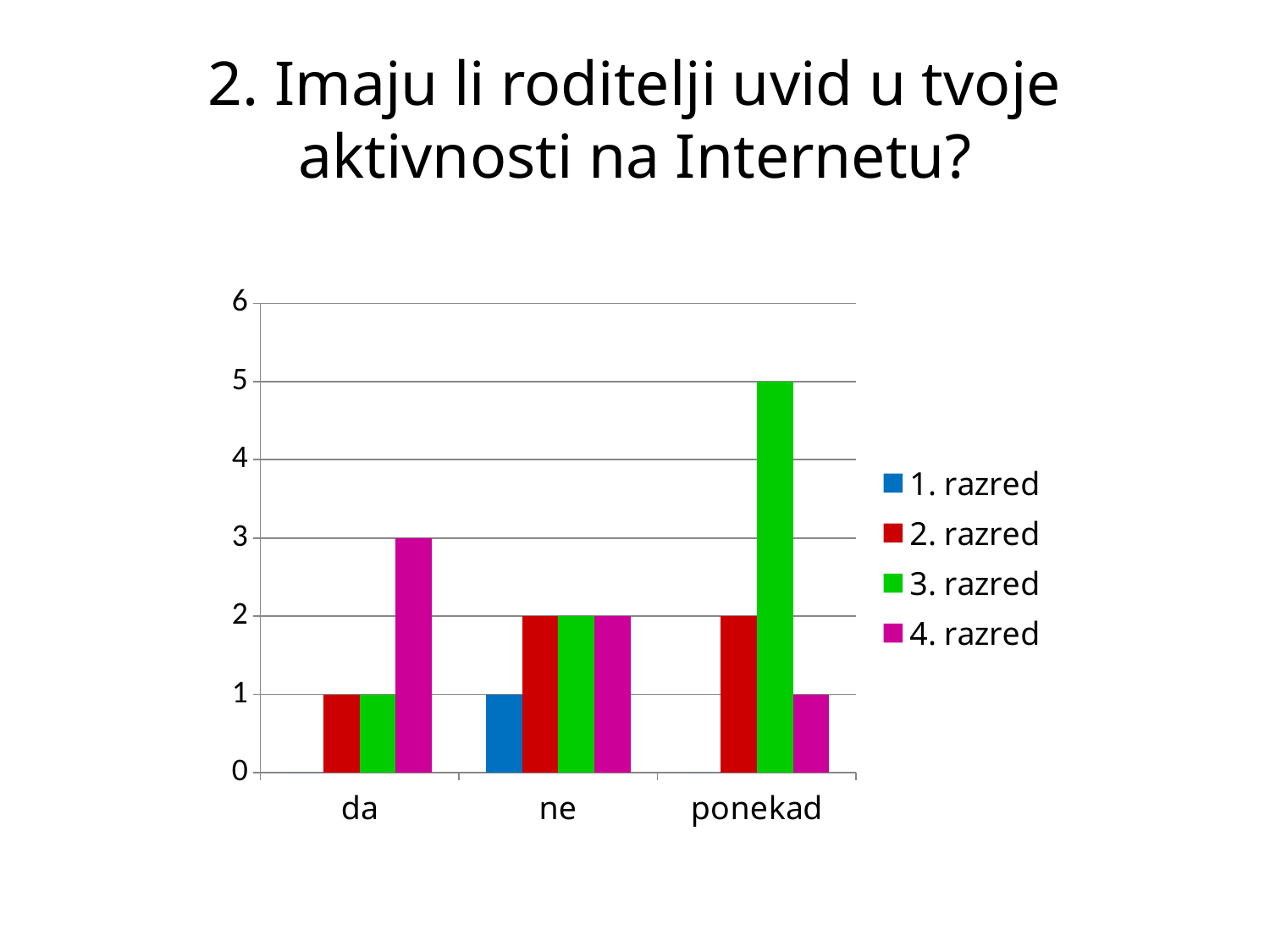
What is the value for 2. razred in the 'ne' category? 2 Which is larger: the 4. razred value for 'da' or the 4. razred value for 'ponekad'? da What is the value for 4. razred in the 'da' category? 3 What kind of chart is shown on the slide? bar chart What is the value for 3. razred in the 'ponekad' category? 5 Which series has the highest value in the 'ponekad' category? 3. razred How many series does the legend list? 4 Which series is shown in green in the legend? 3. razred How many categories are shown on the x axis? 3 What is the difference between the 3. razred value for 'ponekad' and the 3. razred value for 'da'? 4 What is the value for 1. razred in the 'ne' category? 1 Which series has the lowest value in the 'ponekad' category? 1. razred